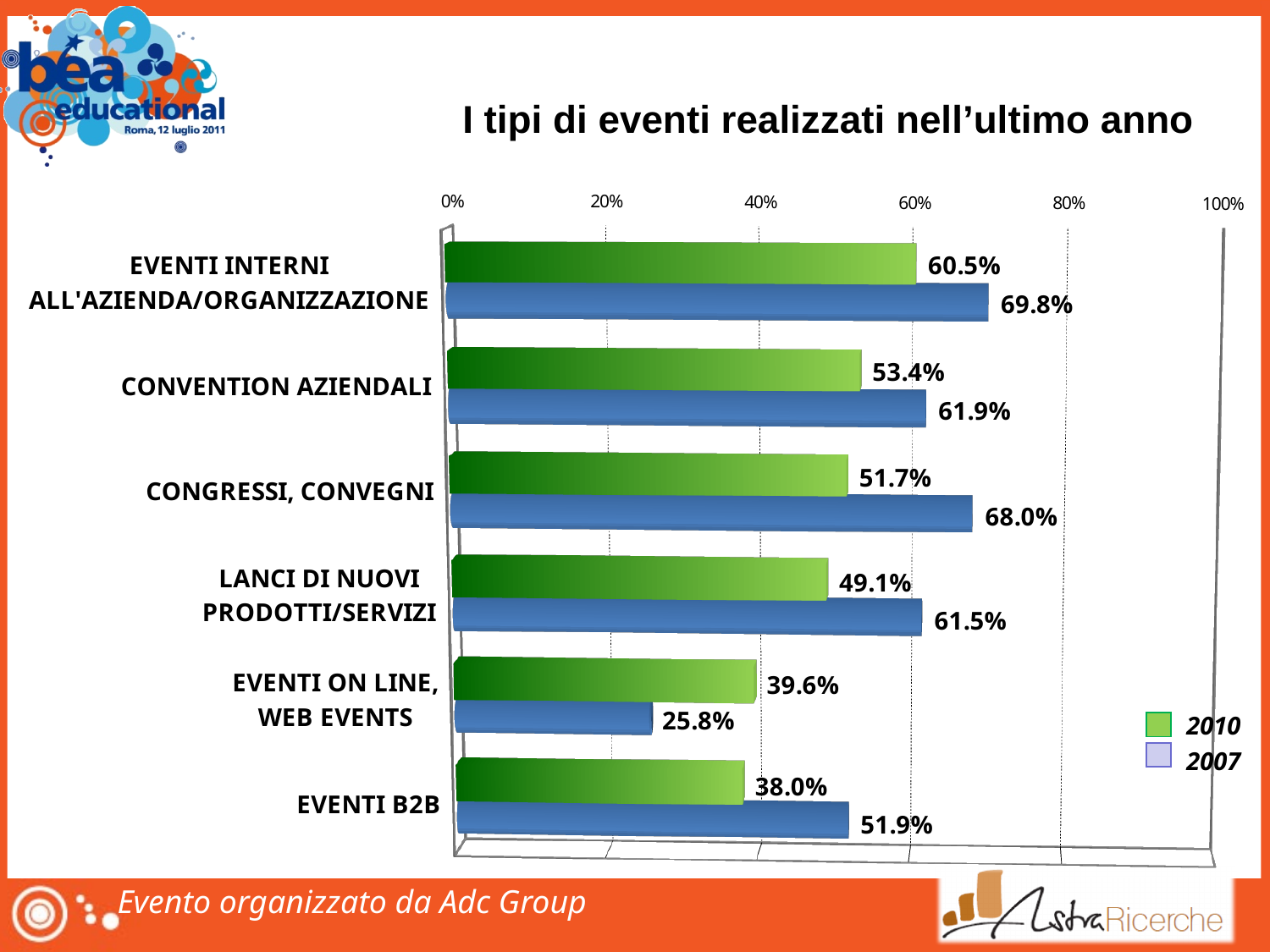
What is the difference between the 2007 and 2010 values for EVENTI B2B? 13.9% How many series does the legend list? 2 Which category has the lowest 2007 value? EVENTI ON LINE, WEB EVENTS Which category has the highest 2010 value? EVENTI INTERNI ALL'AZIENDA/ORGANIZZAZIONE Which colour represents the 2010 series in the legend? Green How many event categories are shown on the chart? 6 What is the 2007 value for EVENTI ON LINE, WEB EVENTS? 25.8% What kind of chart is shown on the slide? Bar chart For EVENTI ON LINE, WEB EVENTS, which year has the larger value, 2010 or 2007? 2010 What is the 2010 value for EVENTI INTERNI ALL'AZIENDA/ORGANIZZAZIONE? 60.5% Is the 2010 value for CONVENTION AZIENDALI greater or less than 40%? greater What is the 2007 value for CONGRESSI, CONVEGNI? 68.0%